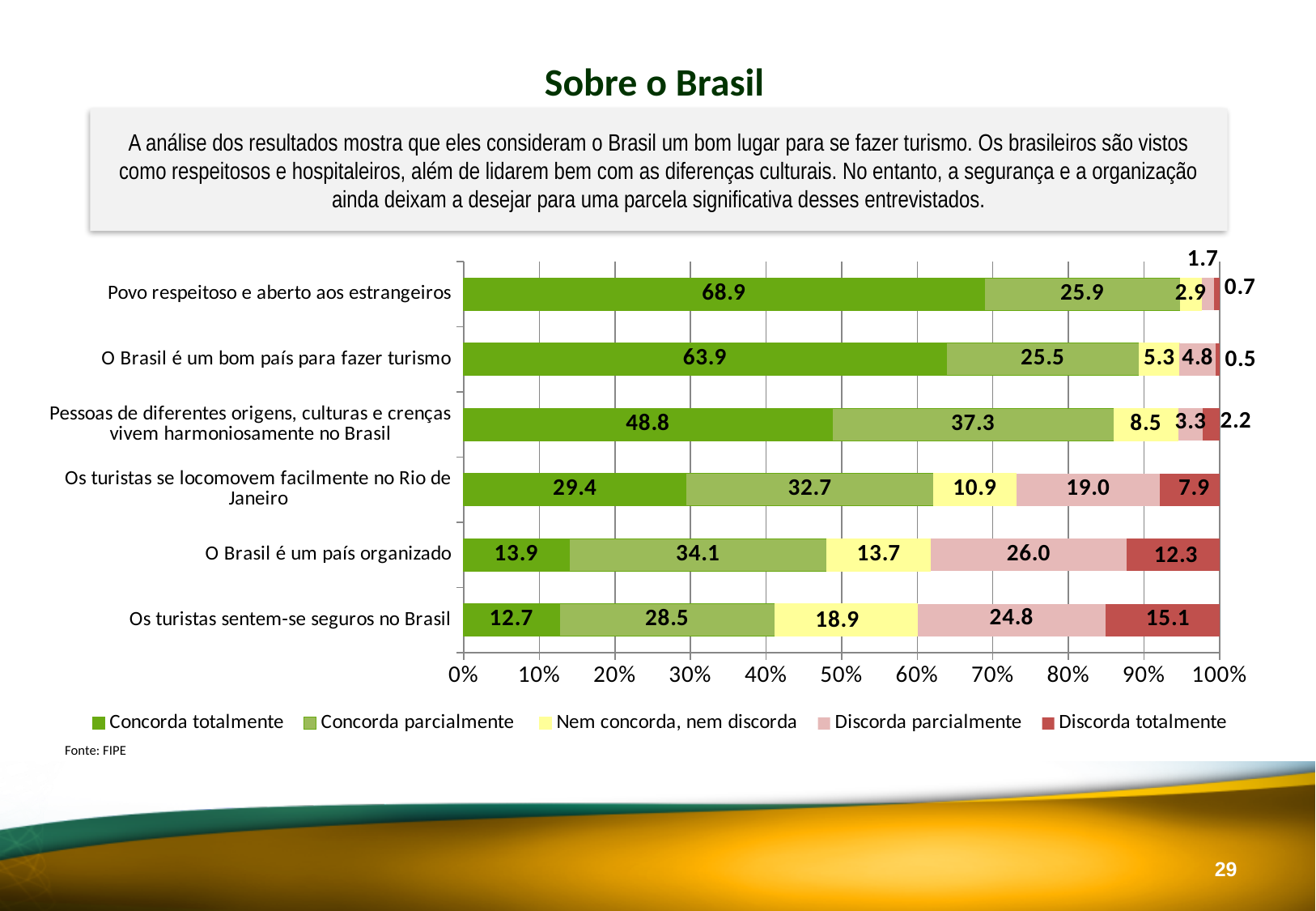
How many statements (categories) are plotted in the chart? 6 What is the 'Nem concorda, nem discorda' value for 'Os turistas se locomovem facilmente no Rio de Janeiro'? 10.9 What is the difference between the 'Concorda totalmente' values for 'Povo respeitoso e aberto aos estrangeiros' and 'O Brasil é um bom país para fazer turismo'? 5.0 How many series does the legend list? 5 What is the source cited below the chart? FIPE Which statement has the lowest 'Concorda totalmente' value? Os turistas sentem-se seguros no Brasil What is the 'Concorda totalmente' value for 'Povo respeitoso e aberto aos estrangeiros'? 68.9 Which statement has the highest 'Concorda totalmente' value? Povo respeitoso e aberto aos estrangeiros What is the 'Discorda parcialmente' value for 'O Brasil é um país organizado'? 26.0 Which is larger: the 'Concorda parcialmente' value for 'Pessoas de diferentes origens, culturas e crenças vivem harmoniosamente no Brasil' or for 'O Brasil é um país organizado'? Pessoas de diferentes origens, culturas e crenças vivem harmoniosamente no Brasil What type of chart is shown on the slide? Stacked bar chart What is the 'Discorda totalmente' value for 'Os turistas sentem-se seguros no Brasil'? 15.1